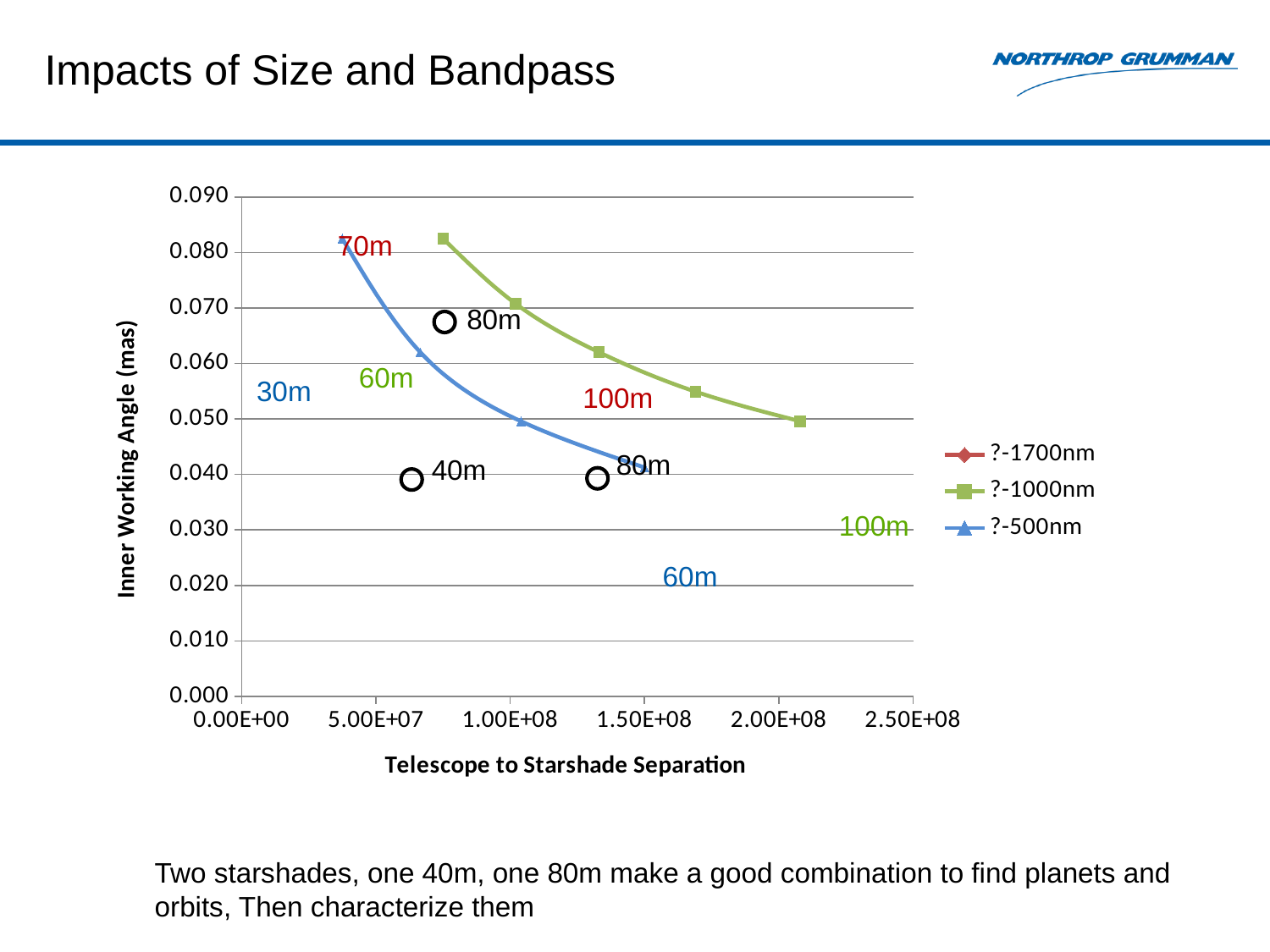
Is the Inner Working Angle of the last (rightmost) point of the ?-1000nm series greater or less than 0.060? less How many data points are plotted for the ?-1000nm series? 5 Which series extends to the largest Telescope to Starshade Separation, ?-1000nm or ?-500nm? ?-1000nm What is the title of the x axis? Telescope to Starshade Separation Is the Inner Working Angle of the last (rightmost) point of the ?-500nm series greater or less than 0.050? less Is the Inner Working Angle of the first (leftmost) point of the ?-1000nm series greater or less than 0.080? greater Does the Inner Working Angle for the ?-500nm series rise or fall as the Telescope to Starshade Separation increases? fall How many series does the legend list? 3 What is the title of the y axis? Inner Working Angle (mas) What kind of chart is shown on the slide? line chart At a separation of 1.00E+08, which series has the larger Inner Working Angle, ?-1000nm or ?-500nm? ?-1000nm Does the Inner Working Angle for the ?-1000nm series rise or fall as the Telescope to Starshade Separation increases? fall